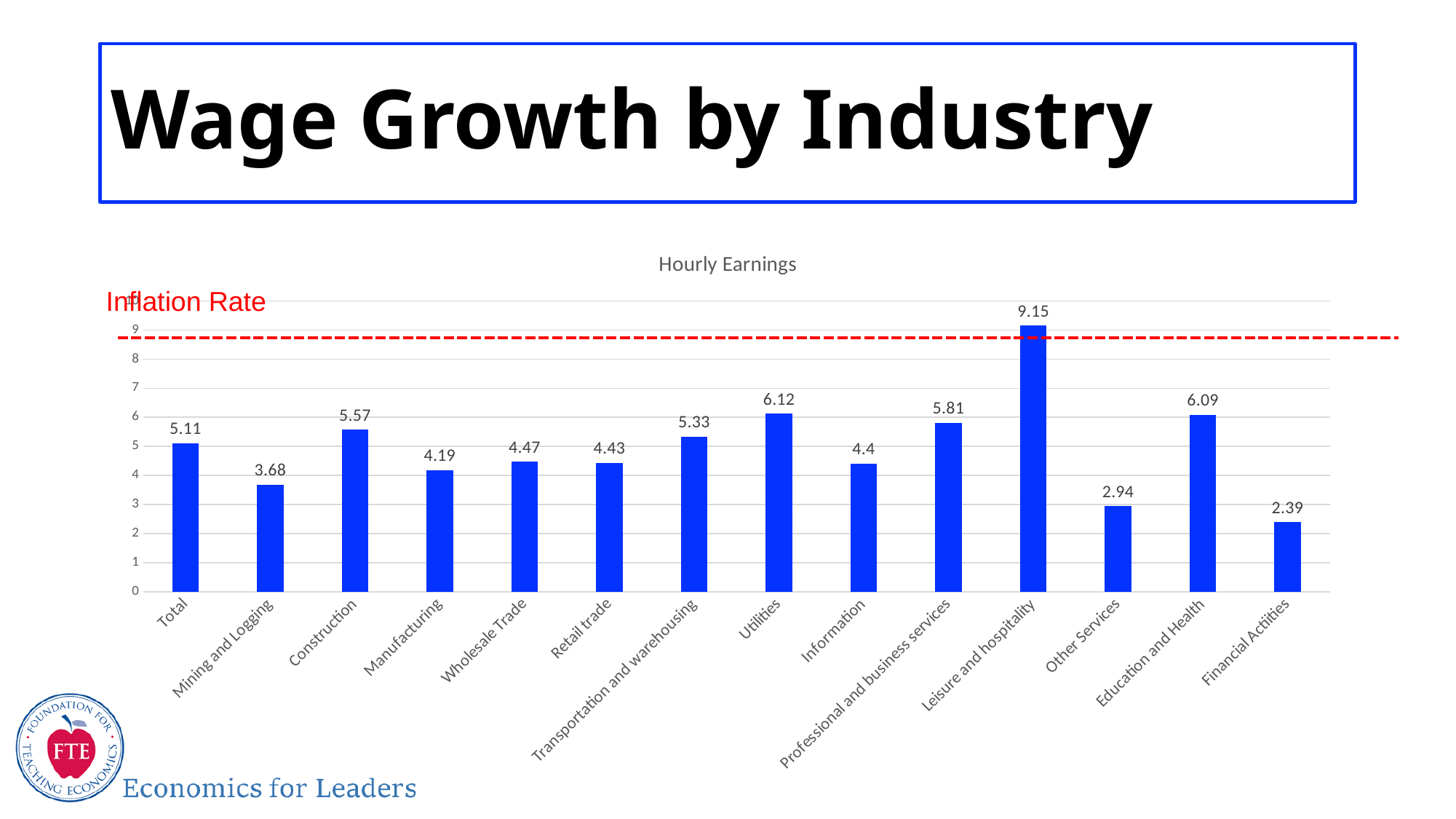
How many categories are shown on the x axis? 14 What is the value for Education and Health? 6.09 What does the red dashed horizontal line represent? Inflation Rate What is the difference between the values for Utilities and Information? 1.72 Which category has the highest value? Leisure and hospitality Which category has the lowest value? Financial Actiities What kind of chart is shown on the slide? bar chart What is the title of the chart? Hourly Earnings What is the value for Mining and Logging? 3.68 What is the value for Leisure and hospitality? 9.15 Is the value for Other Services greater or less than 3? less Which is larger, the value for Construction or the value for Transportation and warehousing? Construction